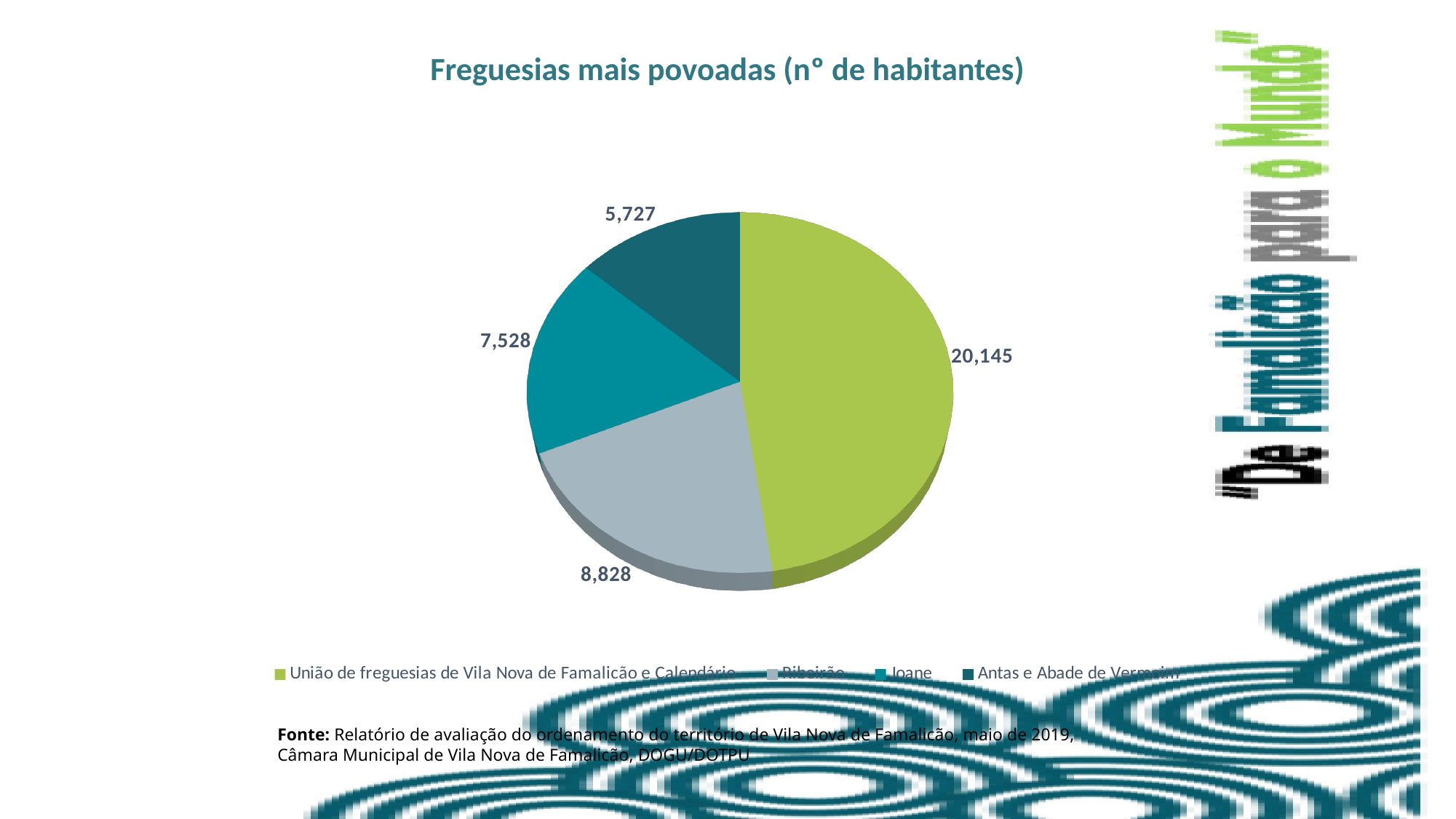
What is the number of inhabitants for União de freguesias de Vila Nova de Famalicão e Calendário? 20,145 What is the difference in inhabitants between União de freguesias de Vila Nova de Famalicão e Calendário and Ribeirão? 11,317 What is the number of inhabitants for Joane? 7,528 Which has more inhabitants, Joane or Antas e Abade de Vermoim? Joane How many slices does the pie chart have? 4 What is the number of inhabitants for Ribeirão? 8,828 How many entries does the legend list? 4 What kind of chart is shown on the slide? Pie chart What is the number of inhabitants for Antas e Abade de Vermoim? 5,727 Which freguesia has the smallest number of inhabitants? Antas e Abade de Vermoim What is the title of the chart? Freguesias mais povoadas (nº de habitantes) Which freguesia has the largest number of inhabitants? União de freguesias de Vila Nova de Famalicão e Calendário